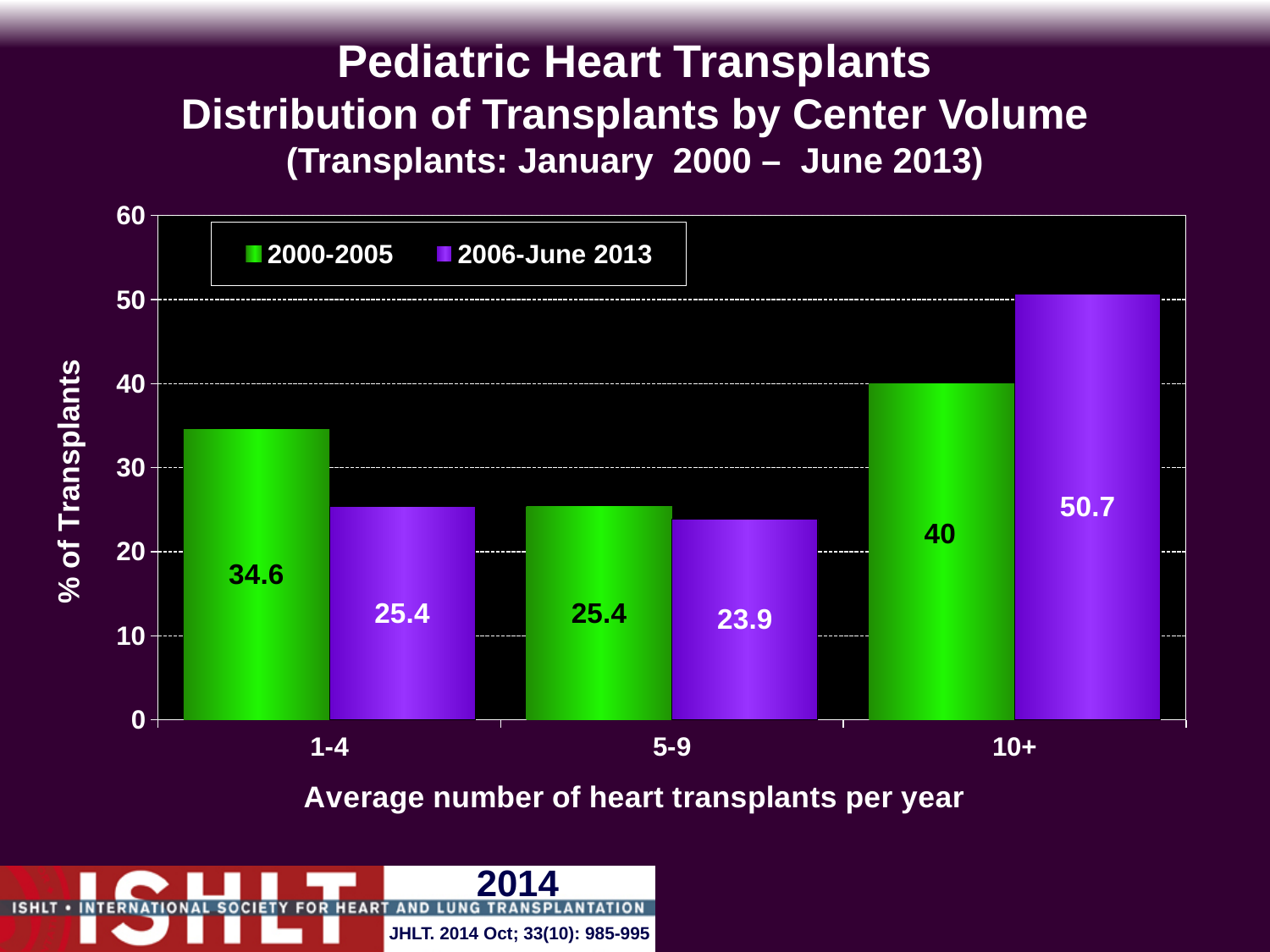
What is the value for the 2006-June 2013 series in the 5-9 category? 23.9 How many categories are shown on the x axis? 3 What type of chart is shown on the slide? bar chart What is the value for the 2000-2005 series in the 10+ category? 40 Is the value for the 2006-June 2013 series in the 10+ category greater or less than 50? greater In the 1-4 category, which series has the larger value, 2000-2005 or 2006-June 2013? 2000-2005 What is the value for the 2006-June 2013 series in the 10+ category? 50.7 Which category has the lowest value for the 2000-2005 series? 5-9 What is the value for the 2000-2005 series in the 1-4 category? 34.6 What is the difference between the 2006-June 2013 and 2000-2005 values in the 10+ category? 10.7 Which category has the highest value for the 2006-June 2013 series? 10+ How many series does the legend list? 2